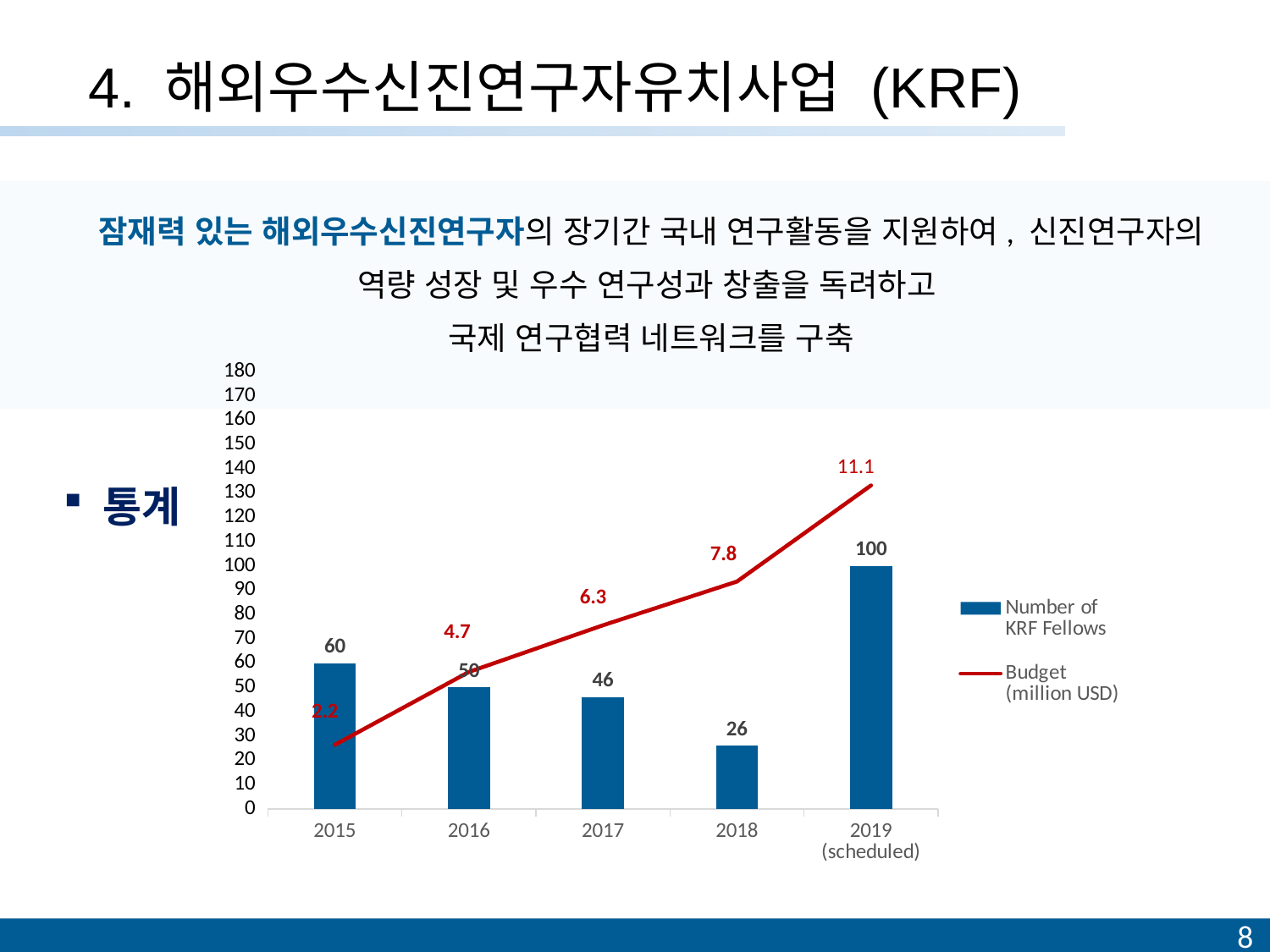
What is the Number of KRF Fellows in 2015? 60 How many years are shown on the x axis of the chart? 5 Which is larger, the Number of KRF Fellows in 2016 or in 2017? 2016 Which year has the highest Number of KRF Fellows? 2019 (scheduled) What is the difference in Number of KRF Fellows between 2019 (scheduled) and 2018? 74 Which year has the lowest Number of KRF Fellows? 2018 What is the Budget (million USD) in 2017? 6.3 Does the Budget (million USD) rise or fall from 2015 to 2019 (scheduled)? rise How many series does the chart legend list? 2 What is the difference in Budget (million USD) between 2018 and 2015? 5.6 What is the Number of KRF Fellows in 2018? 26 What is the Budget (million USD) in 2019 (scheduled)? 11.1